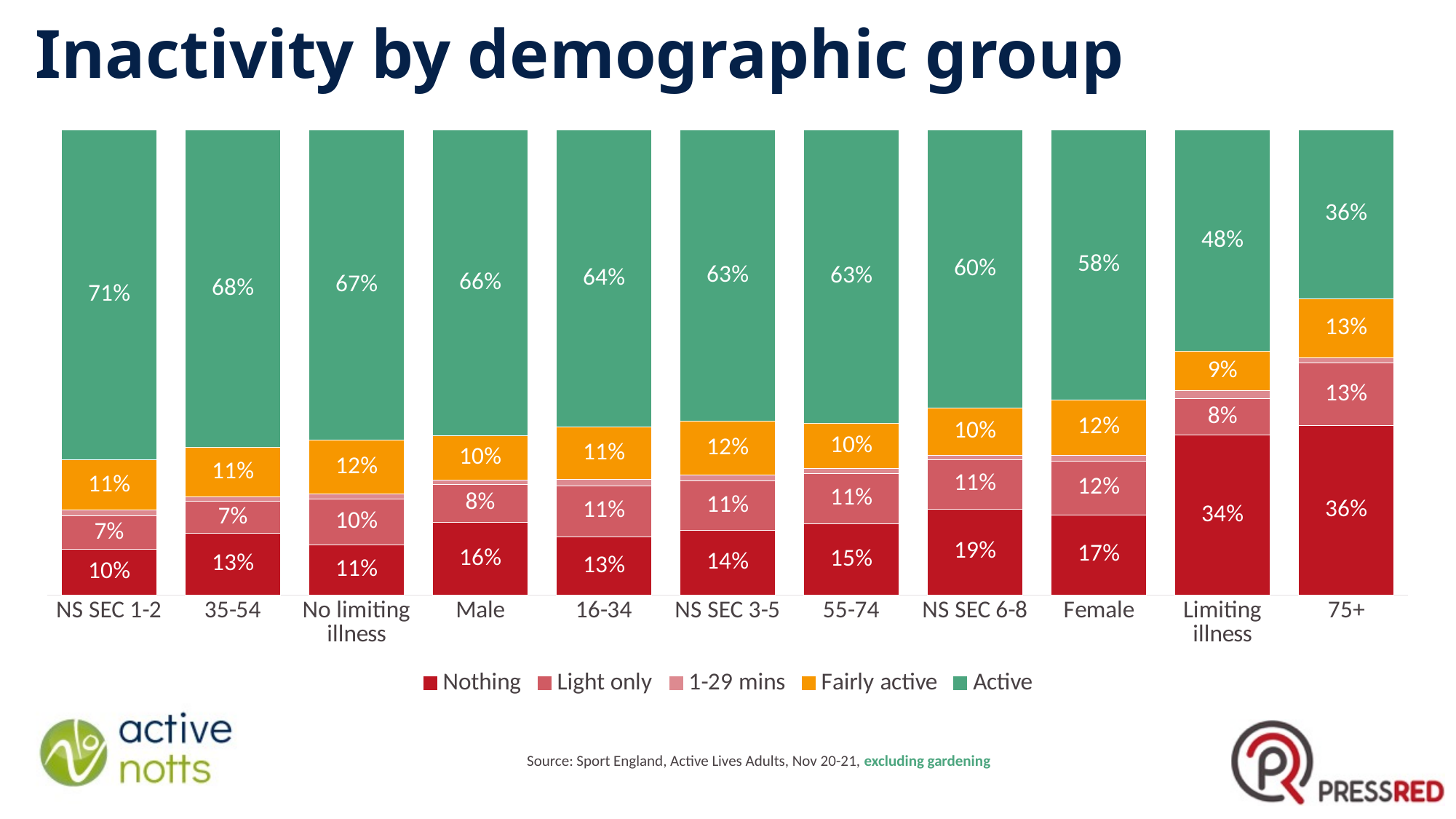
How many demographic groups are shown along the x axis? 11 What is the 'Light only' value for NS SEC 1-2? 7% What type of chart is shown on the slide? Stacked bar chart What is the 'Nothing' value for the Limiting illness group? 34% Which group has the highest 'Active' value? NS SEC 1-2 What is the 'Fairly active' value for Female? 12% Which has a larger 'Active' value, 35-54 or 55-74? 35-54 Do the 'Active' values rise or fall moving from left to right along the x axis? Fall What is the 'Active' value for the 75+ group? 36% Which group has the lowest 'Nothing' value? NS SEC 1-2 How many series does the legend list? 5 What is the difference between the 'Nothing' values for Male and Female? 1%